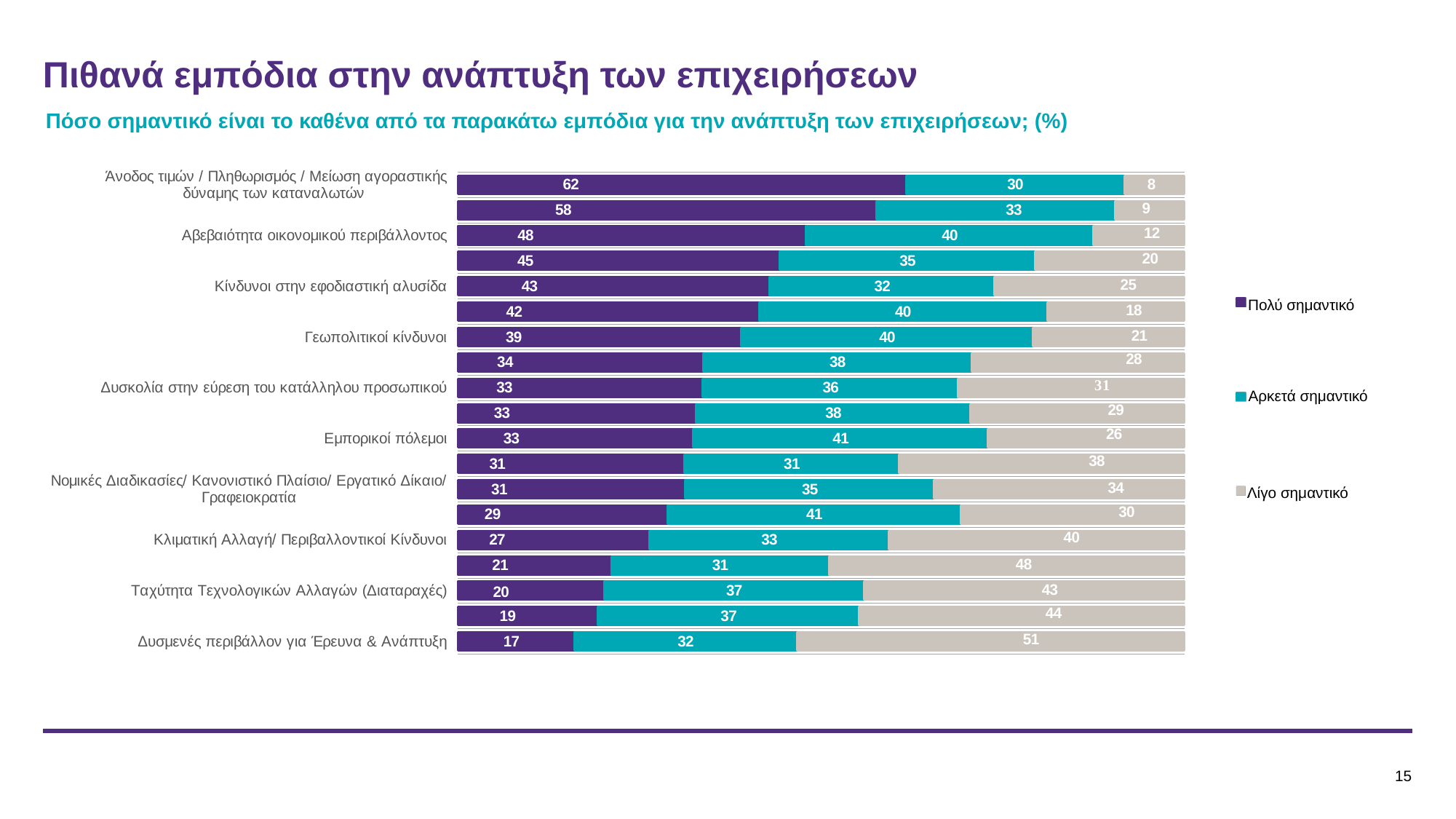
Which labelled category has the highest 'Πολύ σημαντικό' value? Άνοδος τιμών / Πληθωρισμός / Μείωση αγοραστικής δύναμης των καταναλωτών Which legend entry is shown in purple? Πολύ σημαντικό How many series does the legend list? 3 What kind of chart is shown on the slide? Stacked bar chart What is the 'Λίγο σημαντικό' value for 'Δυσμενές περιβάλλον για Έρευνα & Ανάπτυξη'? 51 What is the 'Αρκετά σημαντικό' value for 'Εμπορικοί πόλεμοι'? 41 What is the 'Πολύ σημαντικό' value for 'Κλιματική Αλλαγή/ Περιβαλλοντικοί Κίνδυνοι'? 27 What is the total of the stacked bar for 'Δυσκολία στην εύρεση του κατάλληλου προσωπικού'? 100 Which is larger: the 'Λίγο σημαντικό' value for 'Ταχύτητα Τεχνολογικών Αλλαγών (Διαταραχές)' or for 'Κίνδυνοι στην εφοδιαστική αλυσίδα'? Ταχύτητα Τεχνολογικών Αλλαγών (Διαταραχές) Which labelled category has the lowest 'Πολύ σημαντικό' value? Δυσμενές περιβάλλον για Έρευνα & Ανάπτυξη What is the 'Πολύ σημαντικό' value for 'Άνοδος τιμών / Πληθωρισμός / Μείωση αγοραστικής δύναμης των καταναλωτών'? 62 What is the difference between the 'Πολύ σημαντικό' values for 'Αβεβαιότητα οικονομικού περιβάλλοντος' and 'Γεωπολιτικοί κίνδυνοι'? 9